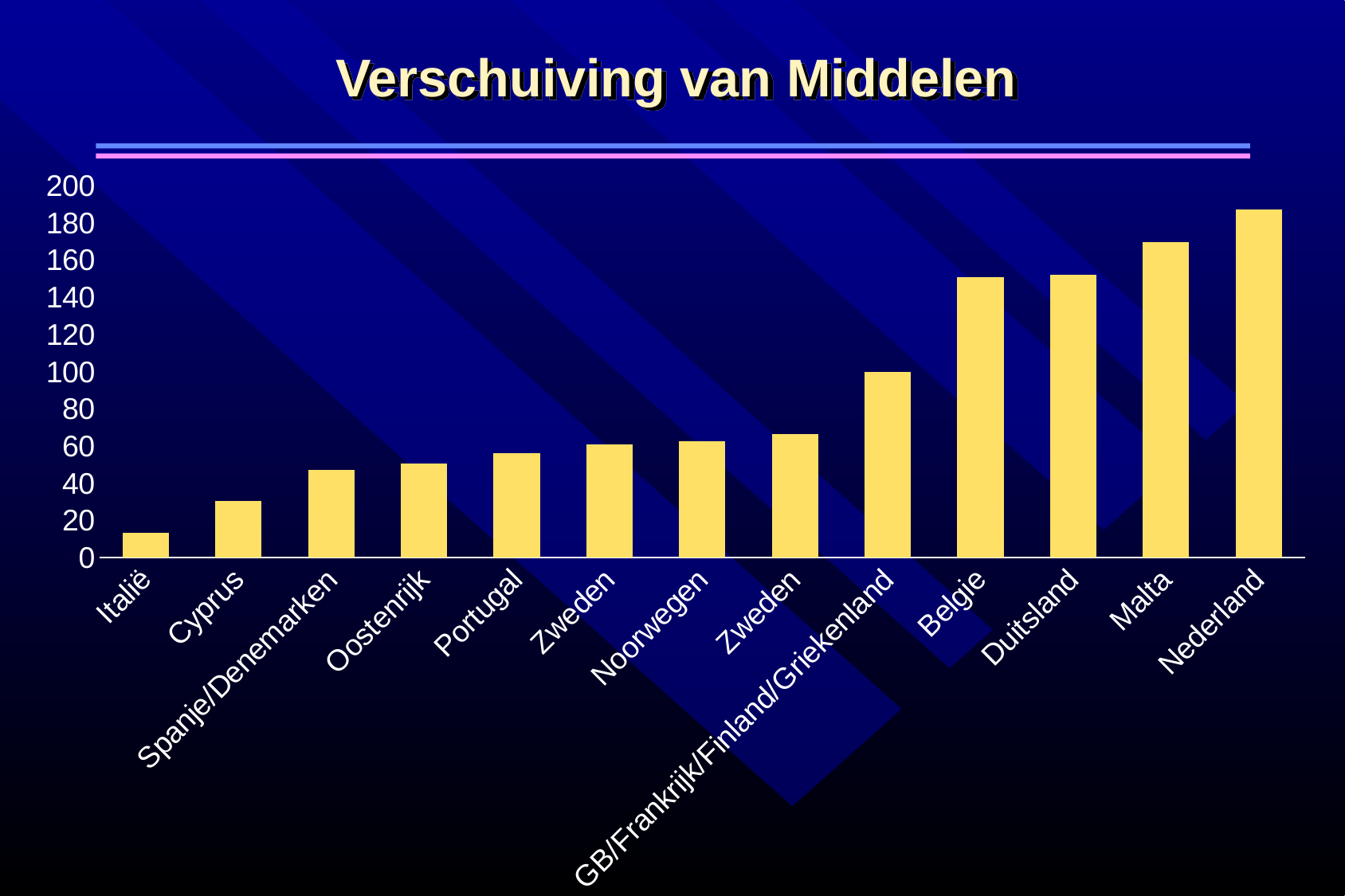
What is the title of the chart? Verschuiving van Middelen Is the value for Malta greater or less than 160? greater Which category has the lowest bar? Italië What kind of chart is shown on the slide? bar chart Is the value for Nederland greater or less than 180? greater Which category has the highest bar? Nederland What is the value for GB/Frankrijk/Finland/Griekenland? 100 Which is larger, the value for Malta or the value for Belgie? Malta Do the bar values generally rise or fall from left to right along the x axis? rise Is the value for Italië greater or less than 20? less How many categories are shown on the x axis of the chart? 13